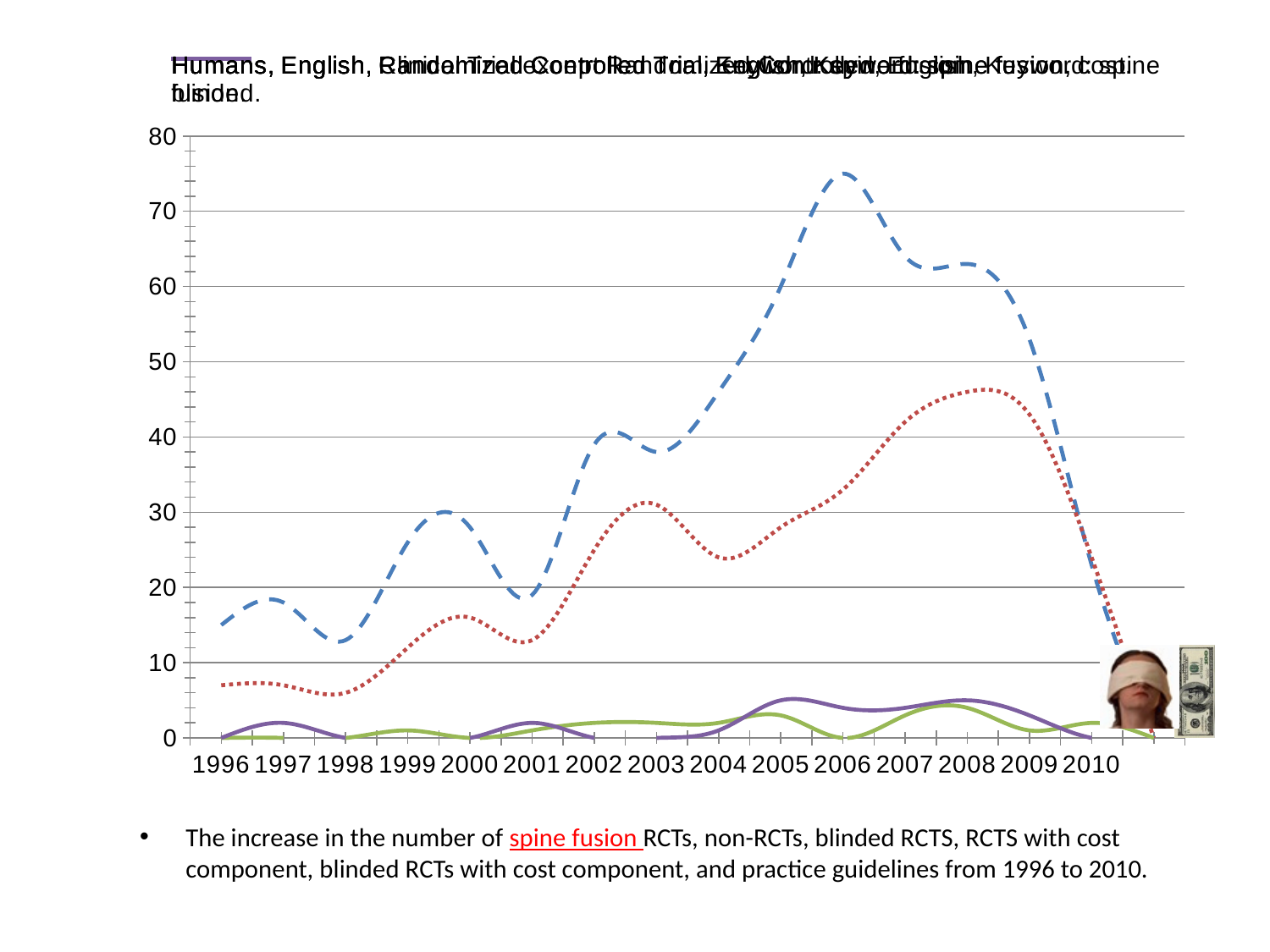
How many years are shown along the x axis of the chart? 15 What kind of chart is shown on the slide? line chart Is the value of the blue dashed line in 2006 greater or less than 70? greater Is the value of the red dotted line in 2008 greater or less than 40? greater Does the blue dashed line rise or fall between 2006 and 2010? fall In which year does the blue dashed line reach its highest value? 2006 Is the value of the blue dashed line in 2010 greater or less than 20? less In which year does the red dotted line reach its highest value? 2008 How many lines are plotted on the chart? 4 What is the highest value shown on the y axis of the chart? 80 At 2006, which line is higher: the blue dashed line or the red dotted line? the blue dashed line